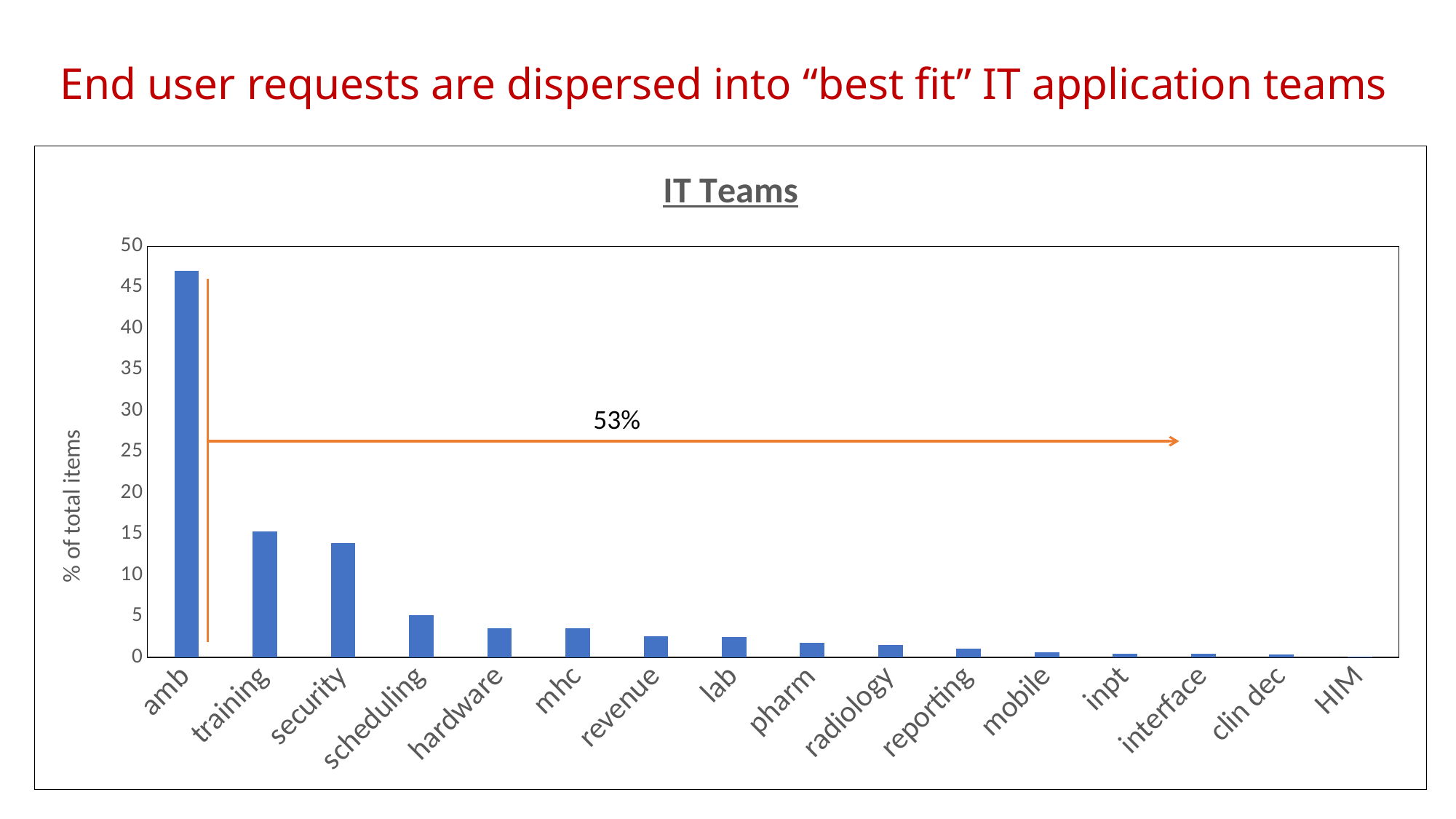
Is the value for scheduling greater or less than 10? less Is the value for security greater or less than 10? greater How many IT teams (categories) are shown on the x axis of the chart? 16 What is the title of the chart? IT Teams What percentage is written above the orange arrow spanning the teams to the right of amb? 53% Which has a higher % of total items, scheduling or amb? amb Is the value for training greater or less than 20? less What kind of chart is shown on the slide? bar chart Which IT team has the highest % of total items? amb Do the bar values rise or fall moving from left to right along the x axis? fall Which has a higher % of total items, training or security? training